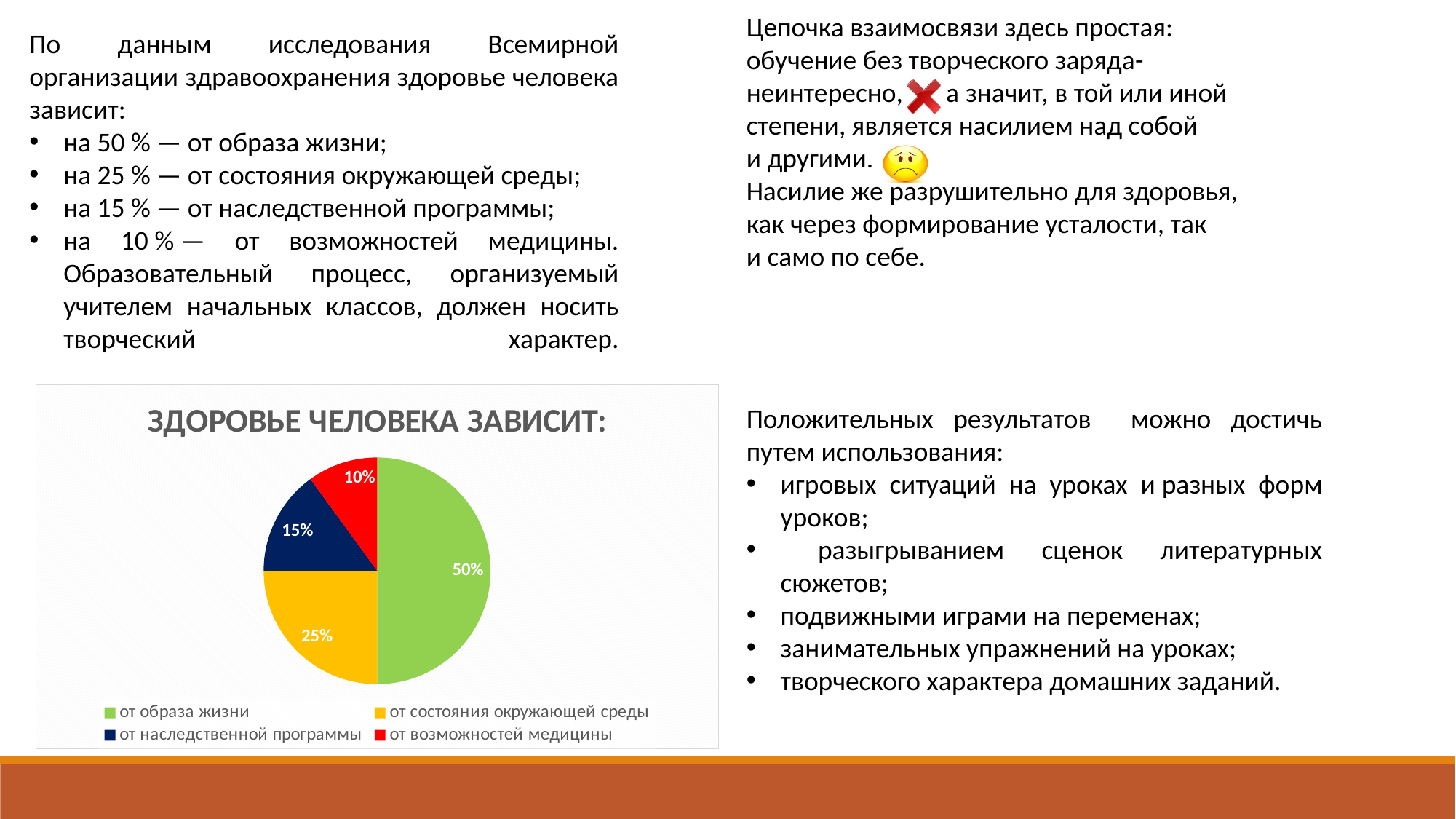
What is the difference between the share for "от образа жизни" and the share for "от состояния окружающей среды"? 25% Which is larger: the share for "от наследственной программы" or the share for "от возможностей медицины"? от наследственной программы What is the title of the chart? ЗДОРОВЬЕ ЧЕЛОВЕКА ЗАВИСИТ: How many slices does the pie chart have? 4 What share of the pie is labelled "от состояния окружающей среды"? 25% What kind of chart is shown on the slide? pie chart Which category has the largest slice of the pie? от образа жизни What share of the pie is labelled "от возможностей медицины"? 10% What share of the pie is labelled "от наследственной программы"? 15% What share of the pie is labelled "от образа жизни"? 50% Which category has the smallest slice of the pie? от возможностей медицины What colour is the slice for "от состояния окружающей среды"? yellow